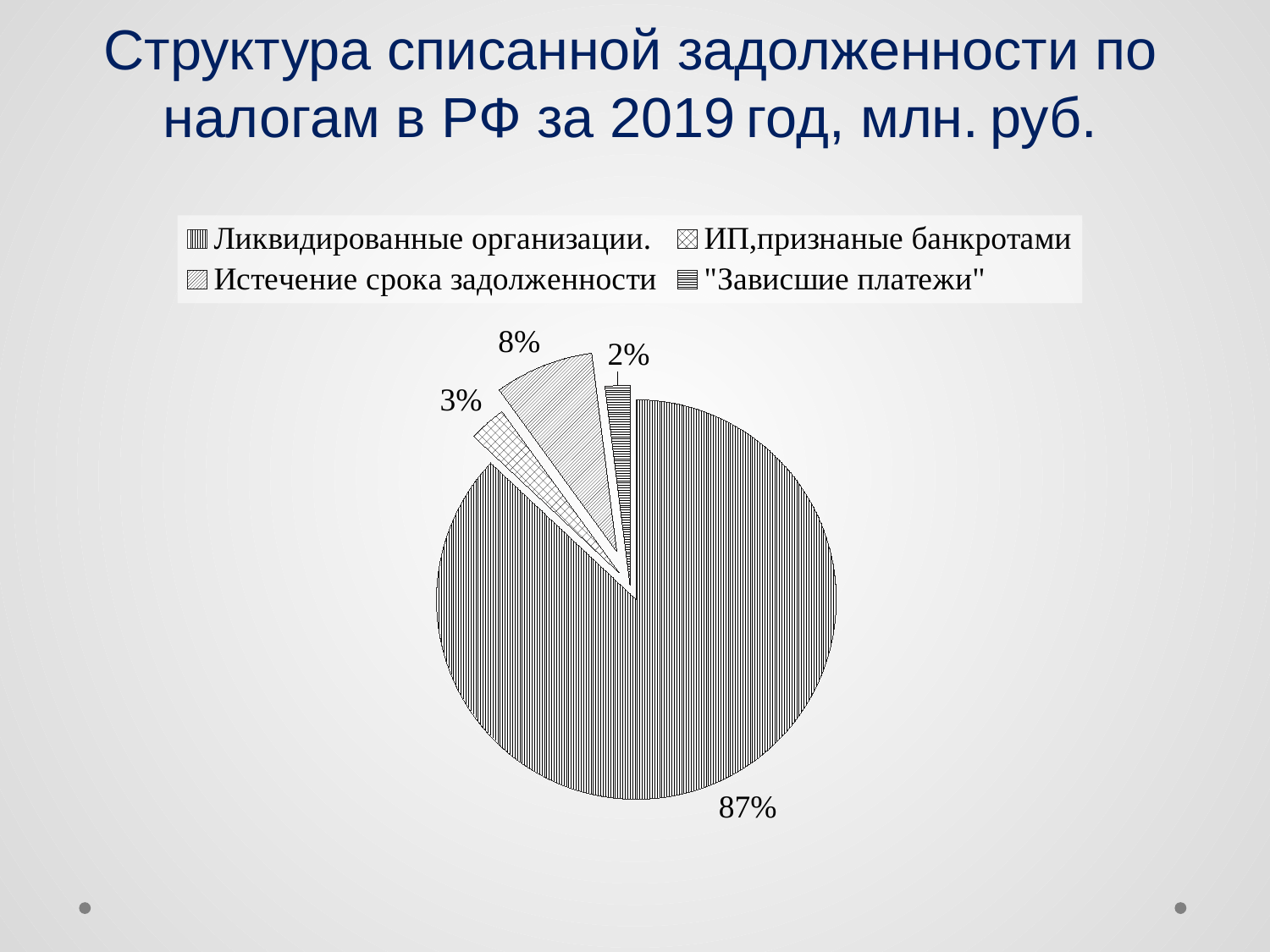
What is the title of the chart on the slide? Структура списанной задолженности по налогам в РФ за 2019 год, млн. руб. Which category has the smallest slice of the pie? Зависшие платежи How many entries does the legend list? 4 What share of the pie does "ИП,признаные банкротами" account for? 3% What is the difference in percentage points between "Истечение срока задолженности" and "ИП,признаные банкротами"? 5% What share of the pie does "Ликвидированные организации" account for? 87% Which is larger: the share for "Истечение срока задолженности" or the share for "Зависшие платежи"? Истечение срока задолженности How many slices does the pie chart have? 4 What share of the pie does "Истечение срока задолженности" account for? 8% Which category has the largest slice of the pie? Ликвидированные организации What kind of chart is shown on the slide? pie chart